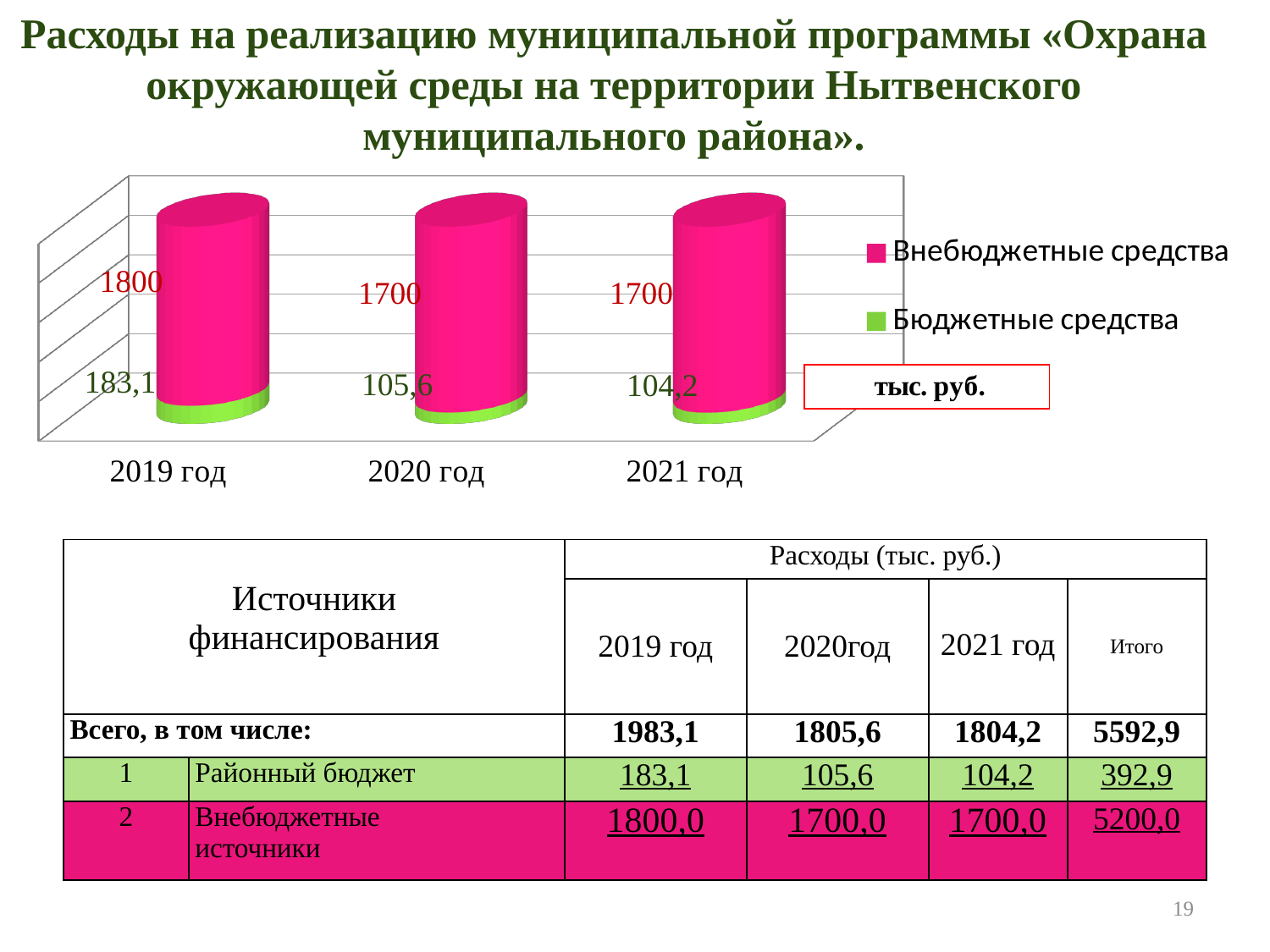
What is the value of Бюджетные средства for 2020 год? 105,6 Which year has the lowest value for Бюджетные средства? 2021 год What is the difference between the Бюджетные средства values for 2019 год and 2020 год? 77,5 How many years are shown on the x axis of the chart? 3 What is the value of Бюджетные средства for 2021 год? 104,2 Which year has the highest value for Бюджетные средства? 2019 год What is the total of the stacked bar for 2019 год? 1983,1 Is the value of Внебюджетные средства larger for 2019 год or for 2020 год? 2019 год What is the value of Внебюджетные средства for 2021 год? 1700 What is the value of Внебюджетные средства for 2019 год? 1800 How many series does the chart legend list? 2 What type of chart is shown on the slide? Stacked bar chart